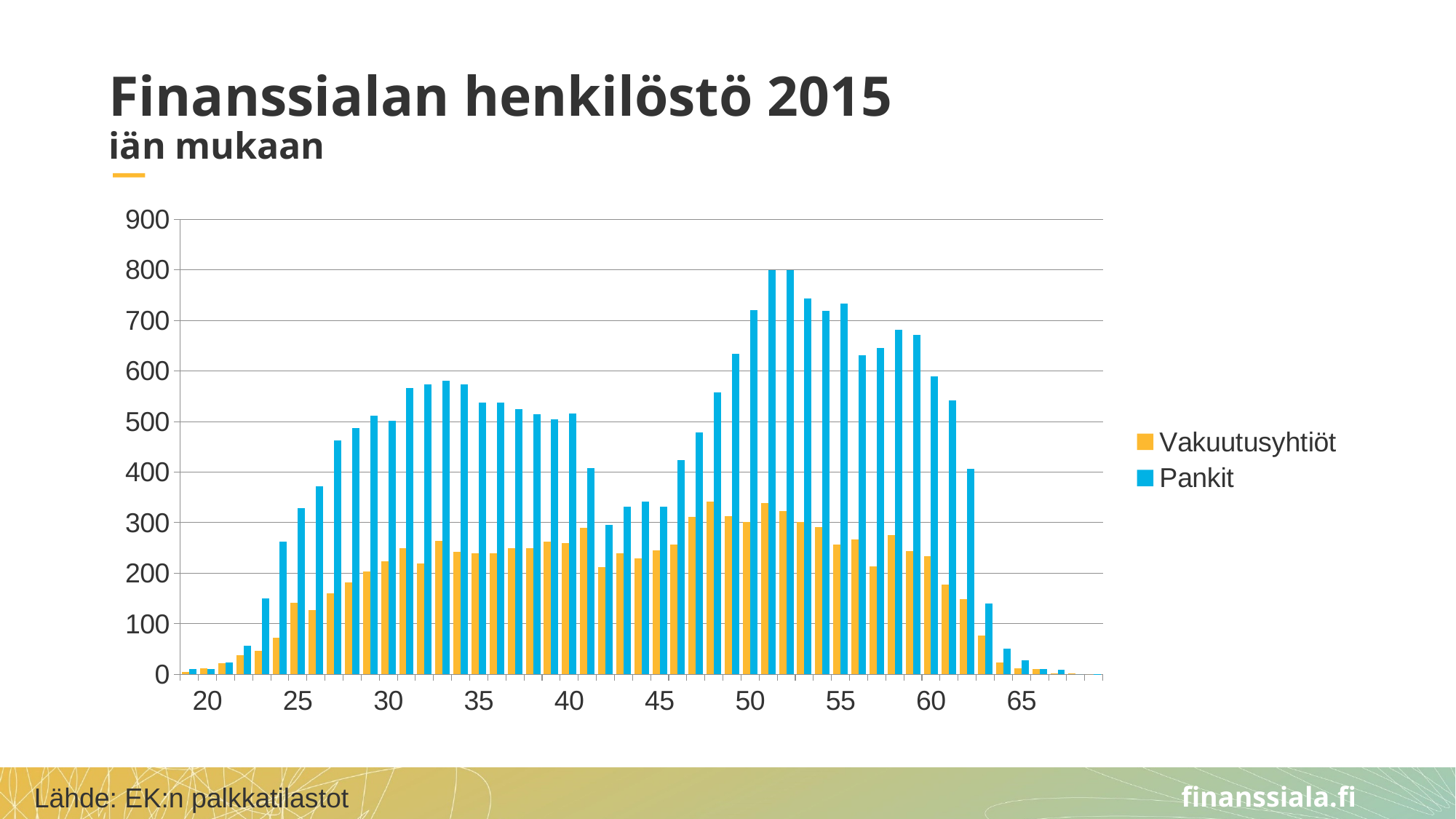
Is the Pankit value at age 65 greater or less than 100? less At age 50, which series has the larger value, Pankit or Vakuutusyhtiöt? Pankit How many series does the legend list? 2 Which series is shown in blue? Pankit What kind of chart is shown on the slide? bar chart Is the Pankit value at age 50 greater or less than 700? greater Is the Vakuutusyhtiöt value at age 25 greater or less than 200? less Do the Pankit values rise or fall from age 45 to age 51? rise What is the title of the chart on the slide? Finanssialan henkilöstö 2015 iän mukaan Do the Pankit values rise or fall from age 60 to age 65? fall